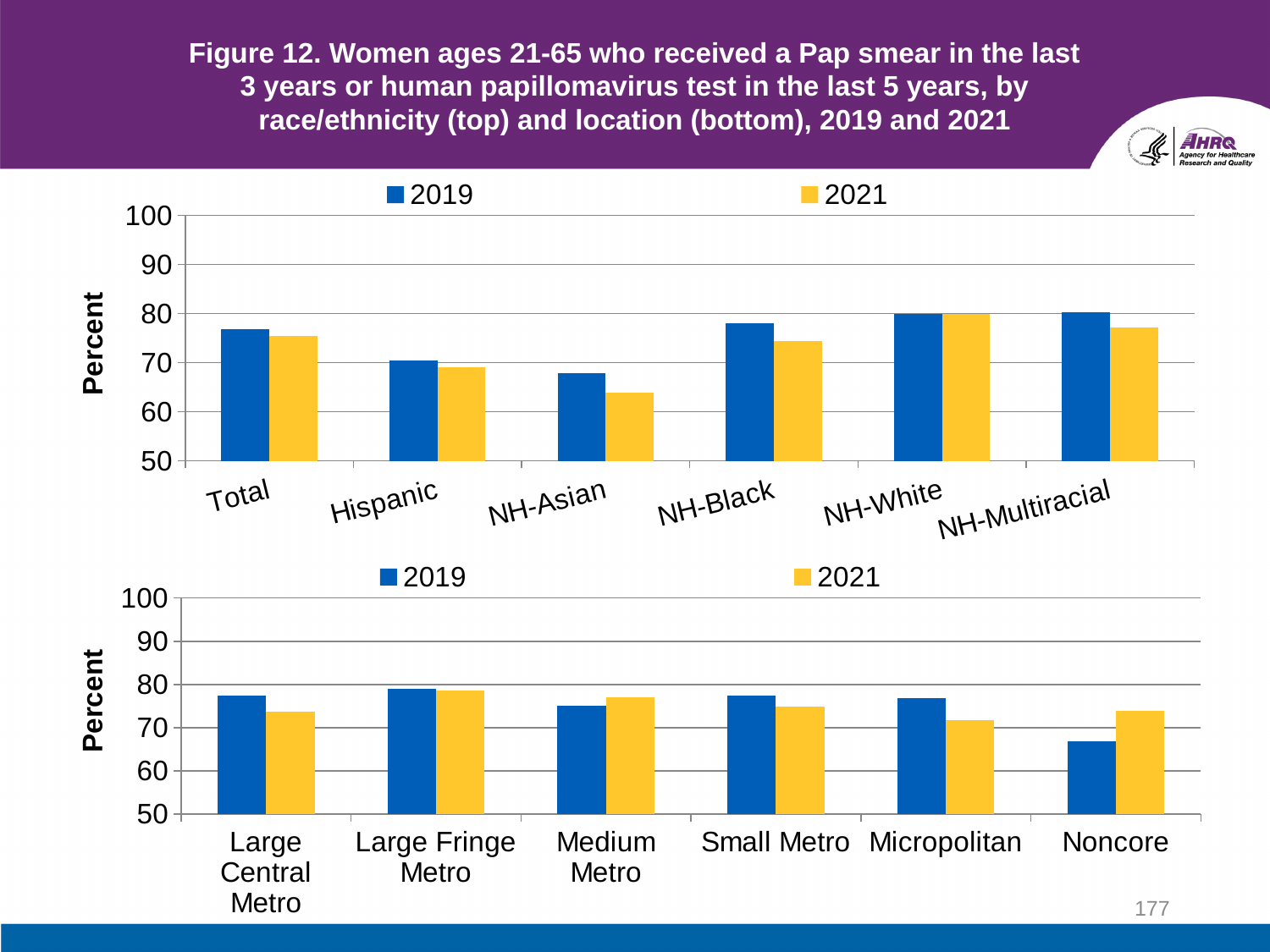
In the top chart (by race/ethnicity), which category has the highest 2021 value? NH-White What is the label on the vertical axis of the top chart? Percent What kind of chart is the top chart (by race/ethnicity)? Bar chart How many location categories are shown on the x axis of the bottom chart? 6 In the top chart (by race/ethnicity), is the 2021 value for NH-Asian greater or less than 70? less In the bottom chart (by location), which category has the highest 2021 value? Large Fringe Metro In the bottom chart (by location), which is larger for Noncore: the 2019 value or the 2021 value? 2021 How many series does the legend of the bottom chart (by location) list? 2 In the bottom chart (by location), which category has the lowest 2019 value? Noncore In the top chart (by race/ethnicity), which category has the lowest 2021 value? NH-Asian How many race/ethnicity categories are shown on the x axis of the top chart? 6 In the bottom chart (by location), is the 2019 value for Noncore greater or less than 70? less